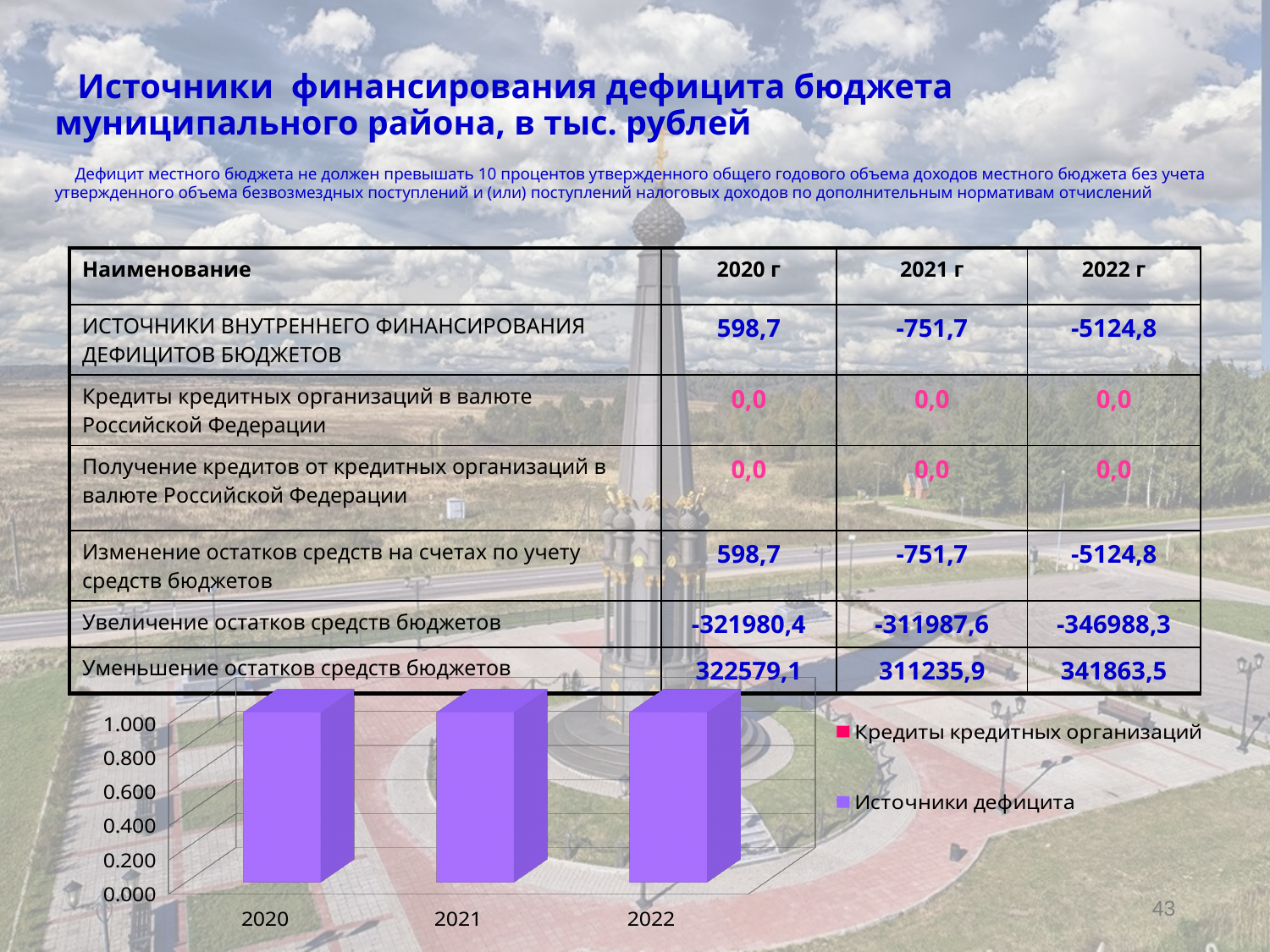
Is the value of the purple bar for 2022 greater or less than 0.400? greater Is the value of the purple bar for 2021 greater or less than 0.600? greater Which legend entry of the bar chart is shown in purple? Источники дефицита How many categories are shown on the x axis of the bar chart? 3 What is the highest tick value shown on the y axis of the bar chart? 1.000 Is the value of the purple bar for 2020 greater or less than 0.800? greater How many series does the legend of the bar chart list? 2 Which years are shown as categories on the x axis of the bar chart? 2020, 2021, 2022 What kind of chart is shown at the bottom of the slide? bar chart